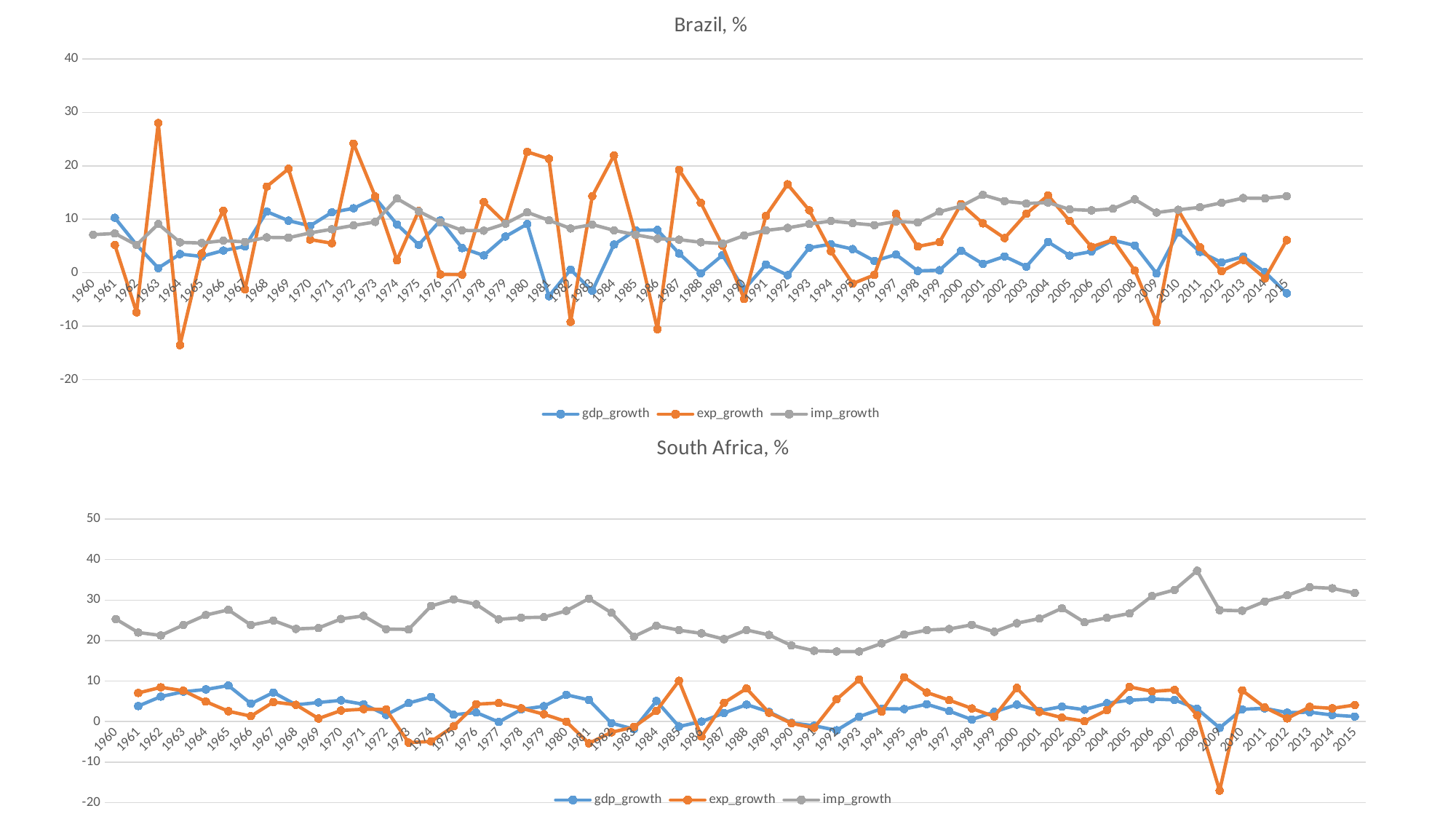
In the South Africa, % chart, is the imp_growth value for 2008 greater or less than 30? greater In the South Africa, % chart, in which year does imp_growth reach its highest value? 2008 In the Brazil, % chart, is the imp_growth value for 2015 greater or less than 10? greater In the Brazil, % chart, which series has the higher value in 1963, exp_growth or gdp_growth? exp_growth In the South Africa, % chart, in which year does exp_growth reach its lowest value? 2009 In the South Africa, % chart, which series is plotted in grey? imp_growth In the Brazil, % chart, in which year does exp_growth reach its lowest value? 1964 In the Brazil, % chart, in which year does exp_growth reach its highest value? 1963 How many series does the legend of the South Africa, % chart list? 3 In the South Africa, % chart, is the exp_growth value for 2009 greater or less than -10? less What type of chart is the Brazil, % chart? line chart How many years are plotted along the x axis of the Brazil, % chart? 56